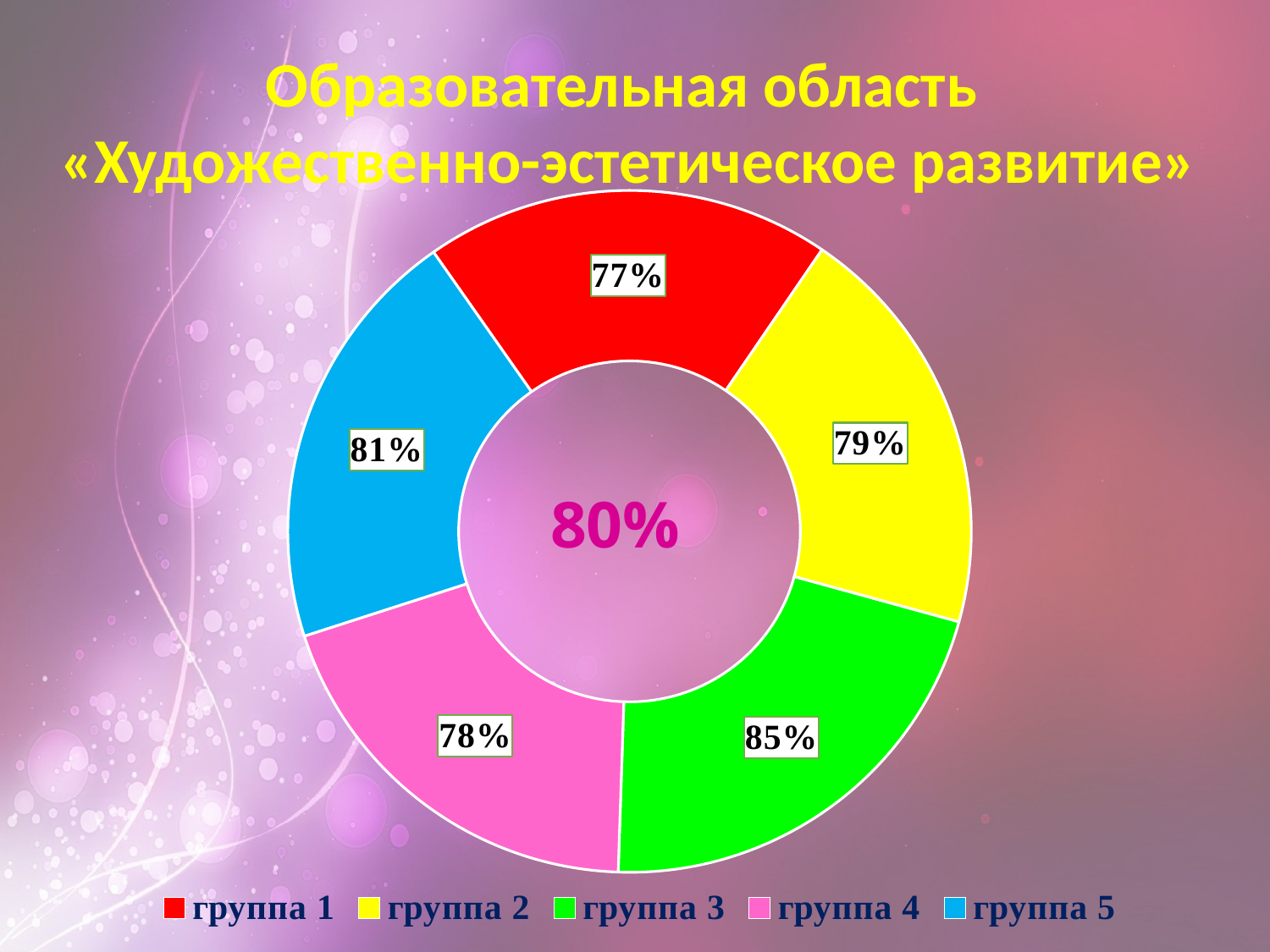
What value is shown for группа 2? 79% Which group has the lowest value? группа 1 Which group has the highest value? группа 3 What value is shown for группа 5? 81% Which has a larger value, группа 5 or группа 2? группа 5 What value is shown for группа 1? 77% What value is shown for группа 3? 85% What value is printed in the centre of the chart? 80% How many groups are shown in the chart? 5 What kind of chart is shown on the slide? doughnut (pie) chart What is the difference between the values for группа 3 and группа 1? 8% What value is shown for группа 4? 78%